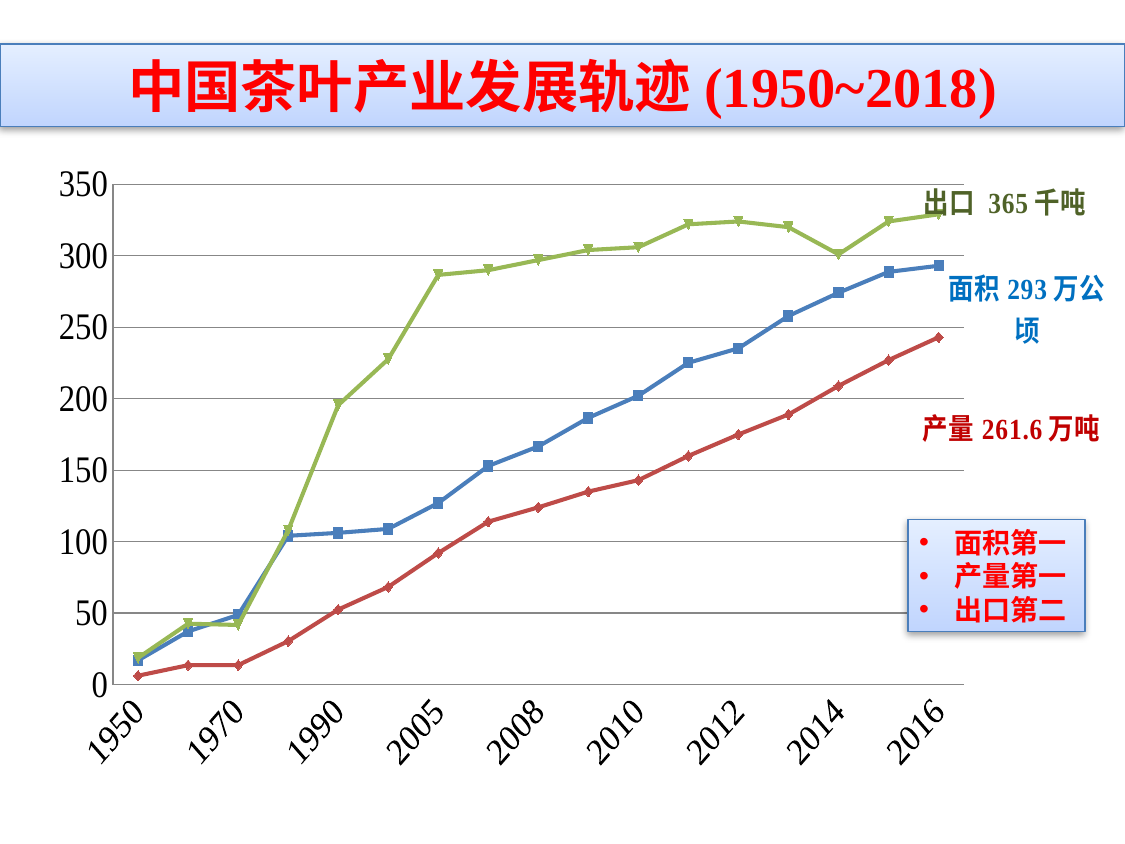
Which series has the highest value at 2016? 出口 Is the 产量 value at 2005 greater or less than 100? less Does the 面积 line rise or fall from 1950 to 2016? rise At 2005, which is larger: the 面积 value or the 产量 value? 面积 Is the 面积 value at 2014 greater or less than 250? greater Which series has the lowest value at 1950? 产量 How many data series (lines) are plotted on the chart? 3 How many year labels are shown on the x axis? 9 What value is written in the annotation next to the 出口 line? 365 千吨 What kind of chart is shown on the slide? line chart Is the 出口 value at 2005 greater or less than 250? greater What is the title of the chart on the slide? 中国茶叶产业发展轨迹 (1950~2018)